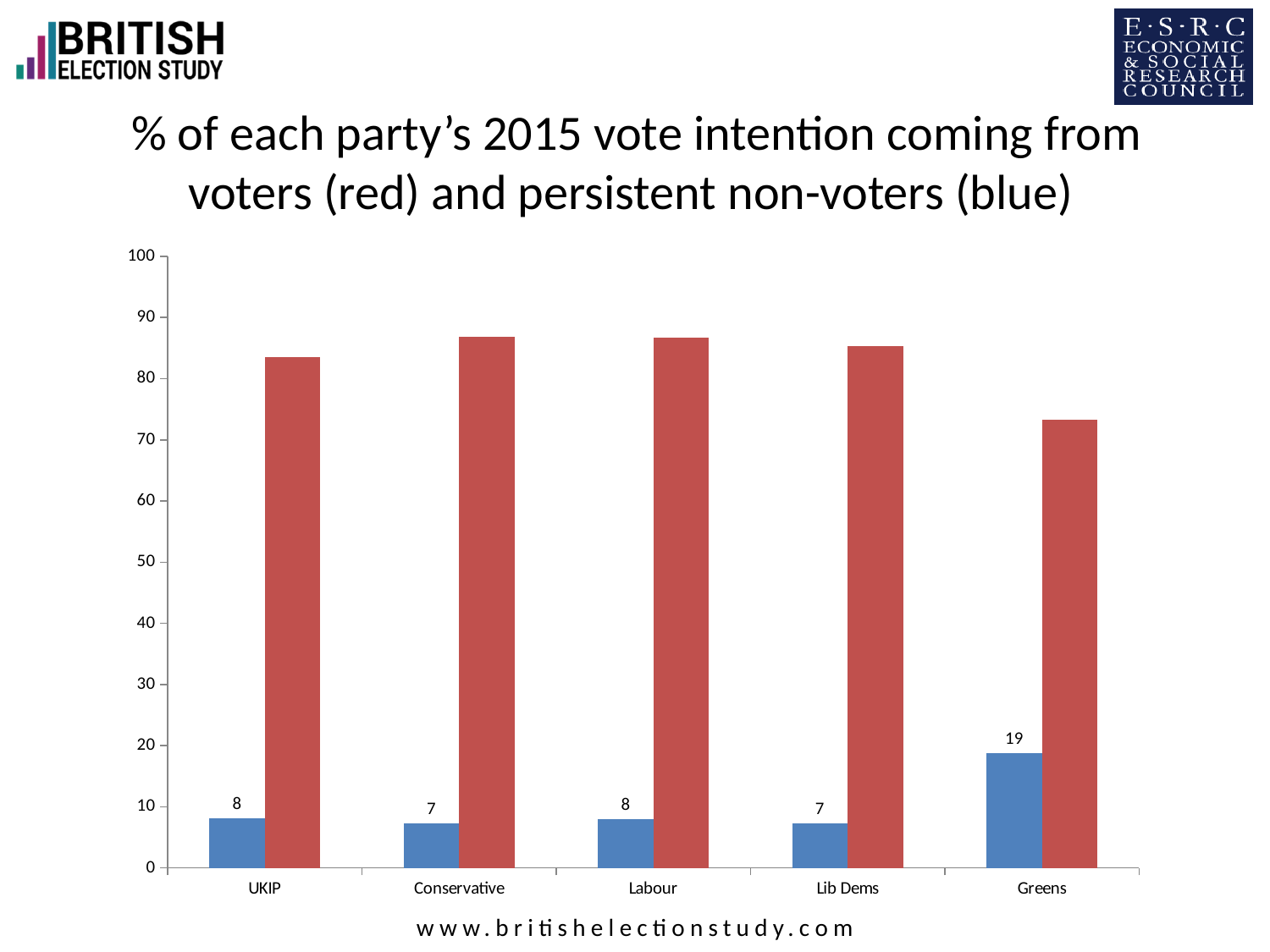
What is the value of the blue bar for UKIP? 8 What is the value of the blue bar for Lib Dems? 7 What is the difference between the blue bar values for Greens and UKIP? 11 Is the red bar for Greens greater or less than 80? less How many parties are shown on the x axis? 5 Which is larger, the blue bar for Greens or the blue bar for Labour? Greens Which is larger, the red bar for Conservative or the red bar for Greens? Conservative What type of chart is shown on the slide? bar chart Which party has the highest blue bar (persistent non-voters)? Greens Which party has the lowest red bar (voters)? Greens Is the red bar for UKIP greater or less than 80? greater What is the value of the blue bar for Greens? 19